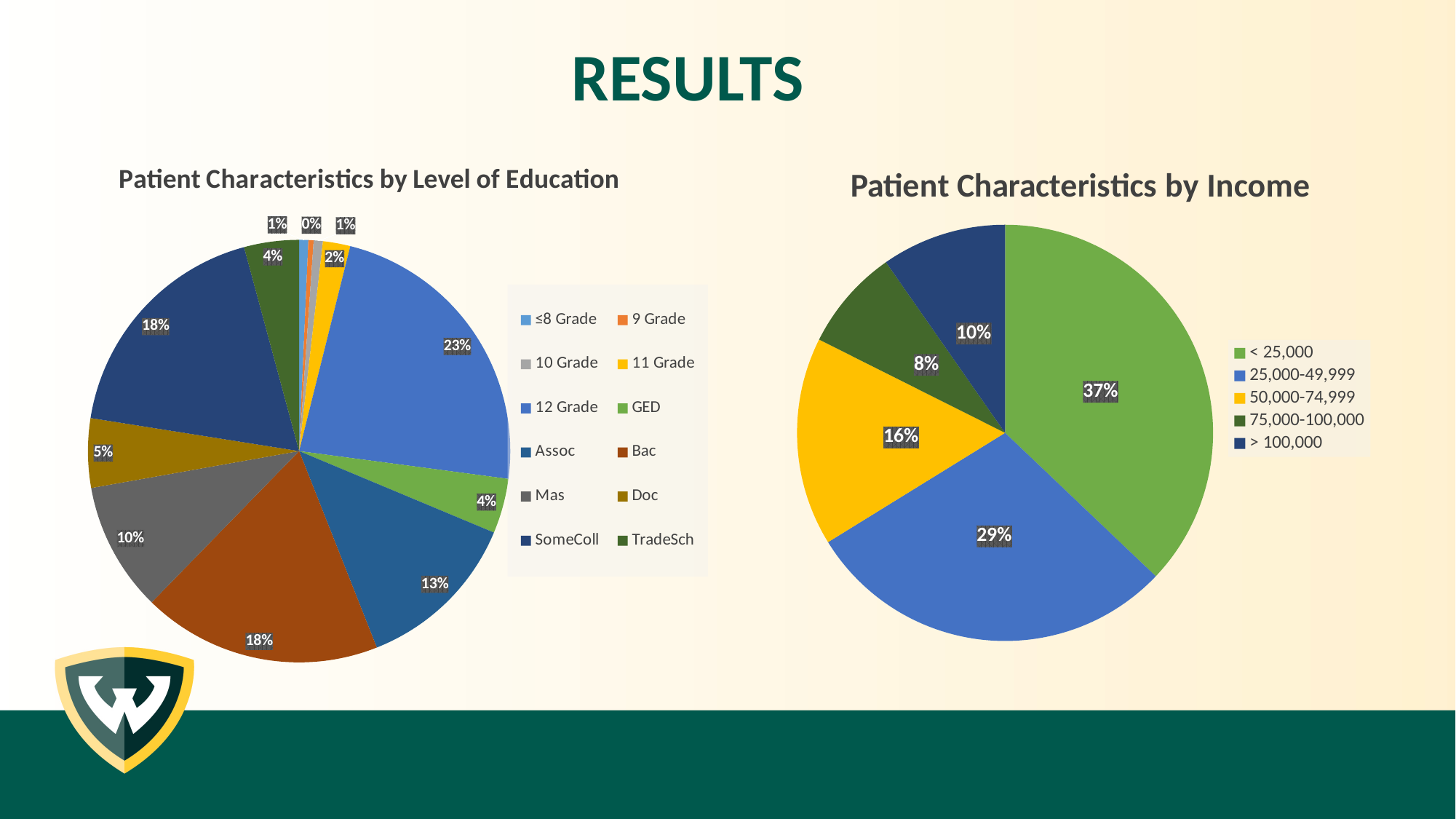
In the 'Patient Characteristics by Level of Education' chart, what share of patients are in the Assoc category? 13% In the 'Patient Characteristics by Level of Education' chart, which education category has the largest share? 12 Grade In the 'Patient Characteristics by Level of Education' chart, which has the larger share, Mas or Doc? Mas In the 'Patient Characteristics by Level of Education' chart, what share of patients are in the Bac category? 18% In the 'Patient Characteristics by Income' chart, which income category has the largest share? < 25,000 In the 'Patient Characteristics by Level of Education' chart, what share of patients are in the 12 Grade category? 23% In the 'Patient Characteristics by Income' chart, how many income categories are shown? 5 In the 'Patient Characteristics by Income' chart, which income category has the smallest share? 75,000-100,000 What type of chart is used for 'Patient Characteristics by Income'? Pie chart In the 'Patient Characteristics by Income' chart, what share of patients have an income of < 25,000? 37% In the 'Patient Characteristics by Income' chart, what is the difference in percentage points between the < 25,000 slice and the 25,000-49,999 slice? 8 percentage points In the 'Patient Characteristics by Income' chart, what share of patients have an income of 50,000-74,999? 16%